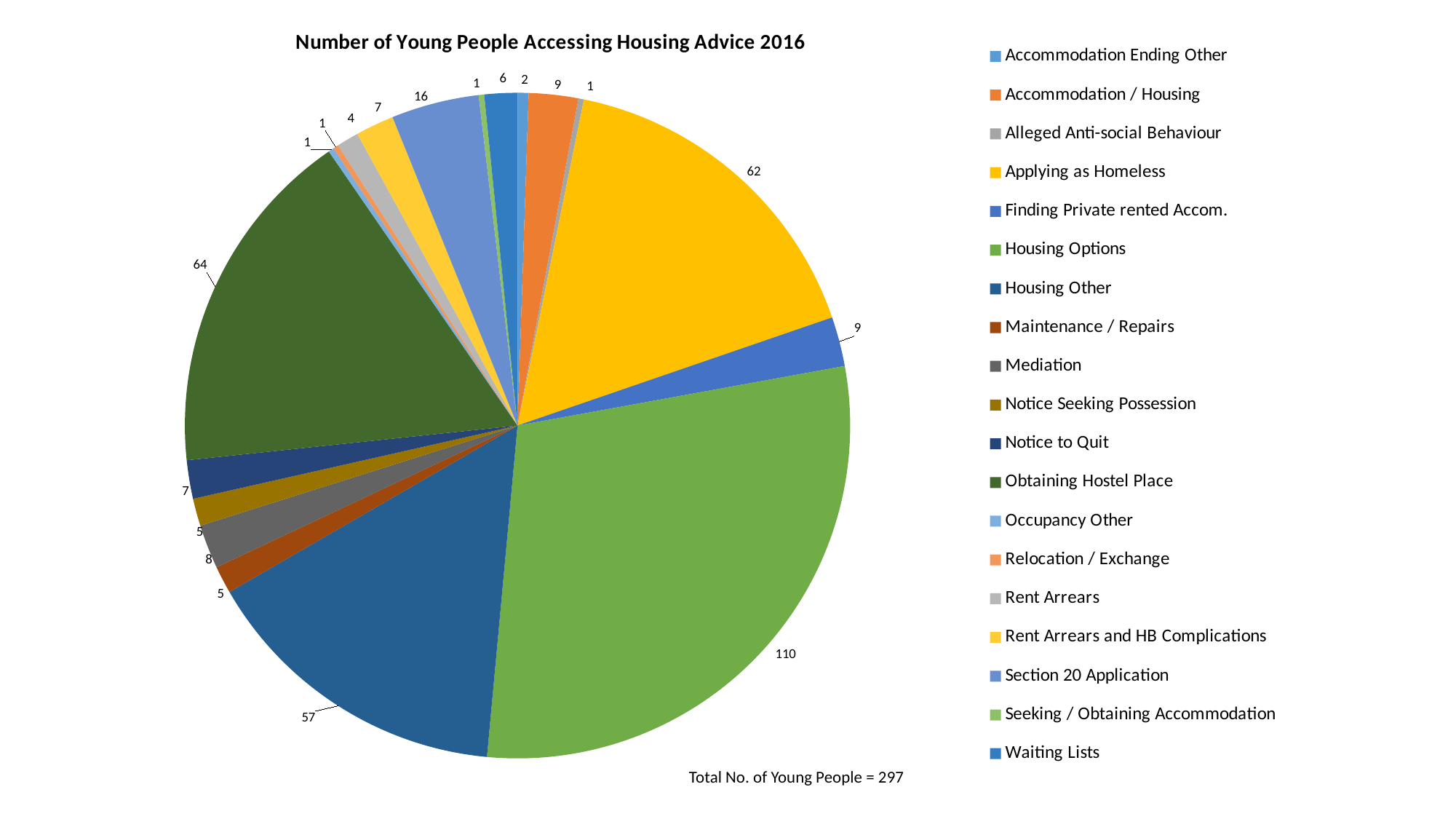
What is the value for Obtaining Hostel Place? 64 What is the value for Section 20 Application? 16 How many categories does the legend list? 19 What is the value for Housing Other? 57 What is the difference between the values for Housing Options and Obtaining Hostel Place? 46 Which category has the largest slice of the pie? Housing Options What total number of young people is stated below the chart? 297 What type of chart is shown on the slide? pie chart What is the title of the chart? Number of Young People Accessing Housing Advice 2016 Which is larger, the value for Housing Other or the value for Applying as Homeless? Applying as Homeless How many young people accessed advice for Housing Options? 110 What is the value for Applying as Homeless? 62